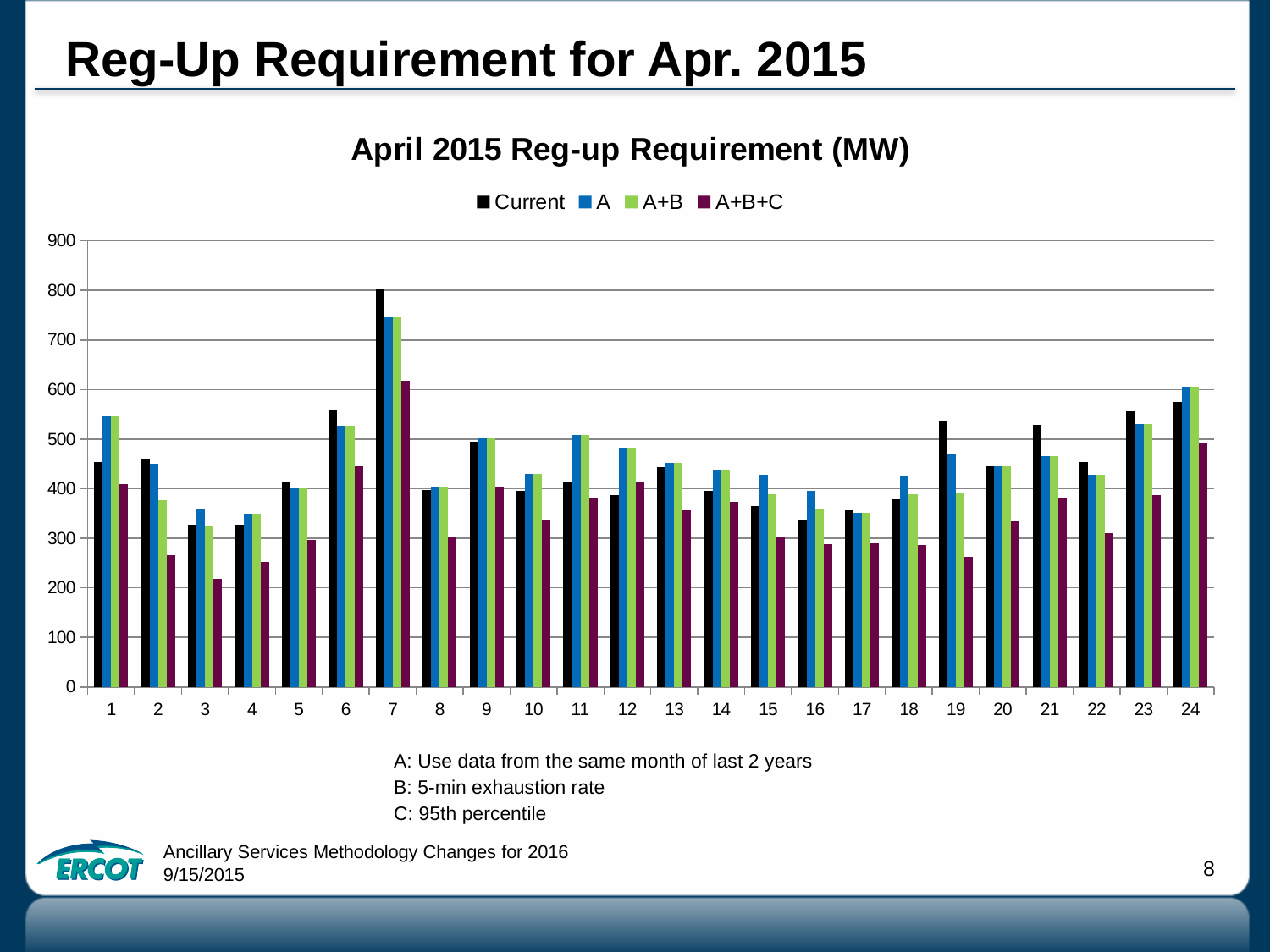
For which hour is the A+B+C value lowest? 3 For which hour is the Current value highest? 7 At hour 1, which is larger: the Current value or the A value? A Is the A+B+C value for hour 3 greater or less than 300? less How many hour categories are shown along the x axis? 24 What kind of chart is shown on the slide? bar chart What is the title of the chart? April 2015 Reg-up Requirement (MW) Is the Current value for hour 7 greater or less than 700? greater At hour 7, which is larger: the Current value or the A+B+C value? Current Is the Current value for hour 24 greater or less than 500? greater How many series does the legend list? 4 Which series is shown in black in the legend? Current